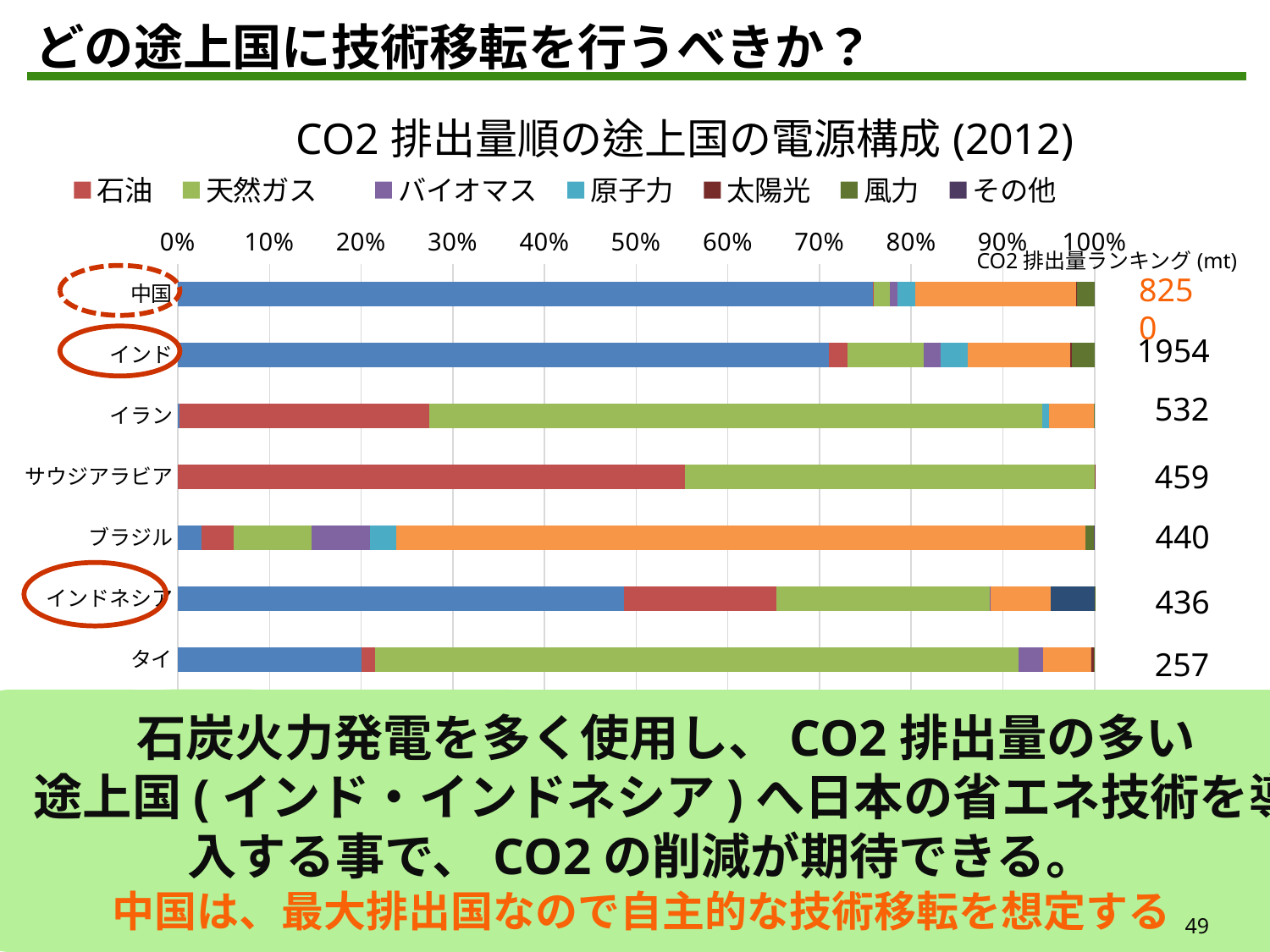
What is the CO2 emission ranking value (mt) shown for タイ? 257 Is the 石油 share for イラン greater or less than 30%? less What is the title of the chart? CO2 排出量順の途上国の電源構成 (2012) What is the difference between the CO2 emission values (mt) shown for インド and イラン? 1422 What is the CO2 emission ranking value (mt) shown for インド? 1954 What kind of chart is shown on the slide? Stacked bar chart Which country has the lowest CO2 emission ranking value (mt) shown on the chart? タイ How many countries are plotted on the chart? 7 How many series does the legend list? 7 Is the 石油 share for サウジアラビア greater or less than 50%? greater What is the CO2 emission ranking value (mt) shown for サウジアラビア? 459 Which country has a larger 石油 share: サウジアラビア or イラン? サウジアラビア